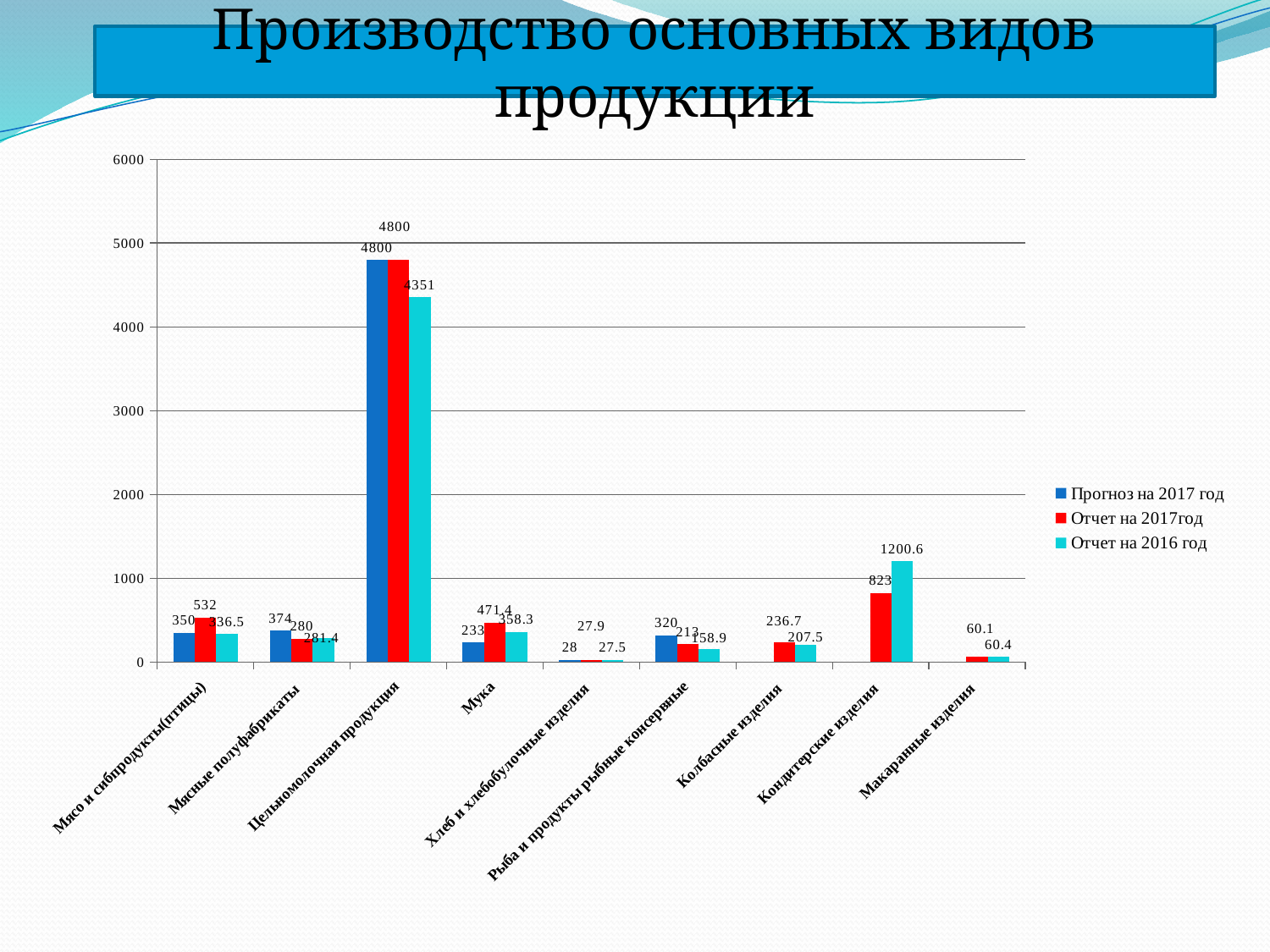
Which category has the highest value for 'Отчет на 2016 год'? Цельномолочная продукция What is the value of 'Отчет на 2017год' for 'Мясо и субпродукты(птицы)'? 532 How many product categories are shown on the x axis? 9 What is the value of 'Прогноз на 2017 год' for 'Мука'? 233 What is the value of 'Отчет на 2017год' for 'Колбасные изделия'? 236.7 What is the title of the chart? Производство основных видов продукции For 'Кондитерские изделия', which is larger: 'Отчет на 2017год' or 'Отчет на 2016 год'? Отчет на 2016 год Which category has the lowest value for 'Отчет на 2016 год'? Хлеб и хлебобулочные изделия What is the value of 'Отчет на 2016 год' for 'Кондитерские изделия'? 1200.6 What kind of chart is shown on the slide? Bar chart How many series does the legend list? 3 For 'Цельномолочная продукция', what is the difference between 'Отчет на 2017год' and 'Отчет на 2016 год'? 449